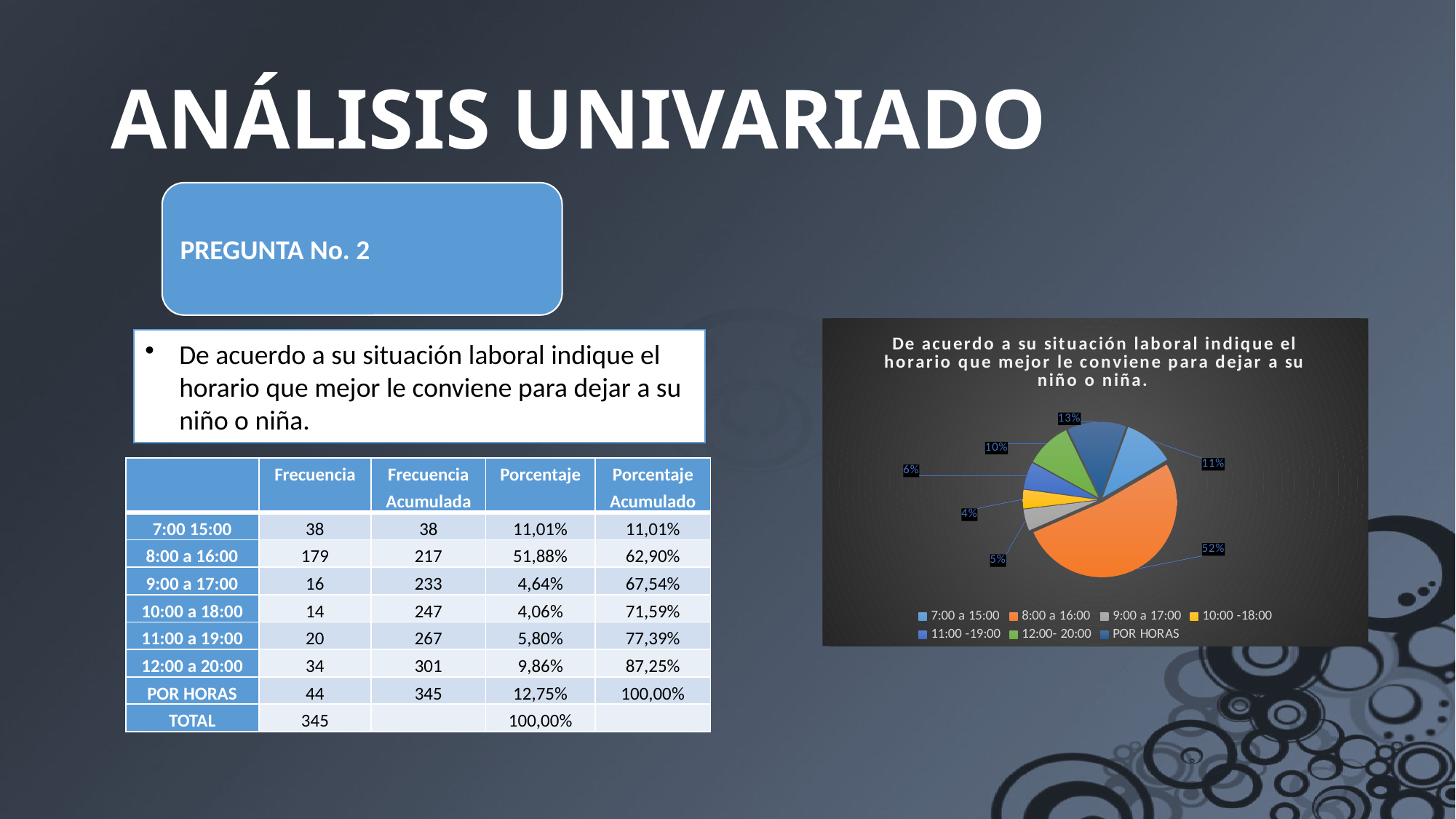
What is the difference in percentage points between the 8:00 a 16:00 slice and the POR HORAS slice in the pie chart? 39 How many slices does the pie chart have? 7 In the pie chart, what percentage is shown for the 12:00- 20:00 slice? 10% In the pie chart, what percentage is shown for the 8:00 a 16:00 slice? 52% Which slice is larger in the pie chart, POR HORAS or 12:00- 20:00? POR HORAS In the pie chart, what percentage is shown for the 10:00 -18:00 slice? 4% In the pie chart, what percentage is shown for the POR HORAS slice? 13% What colour is the 8:00 a 16:00 slice in the pie chart? orange Which category has the largest slice in the pie chart? 8:00 a 16:00 What kind of chart is shown on the slide? pie chart Which category has the smallest slice in the pie chart? 10:00 -18:00 In the pie chart, what percentage is shown for the 7:00 a 15:00 slice? 11%